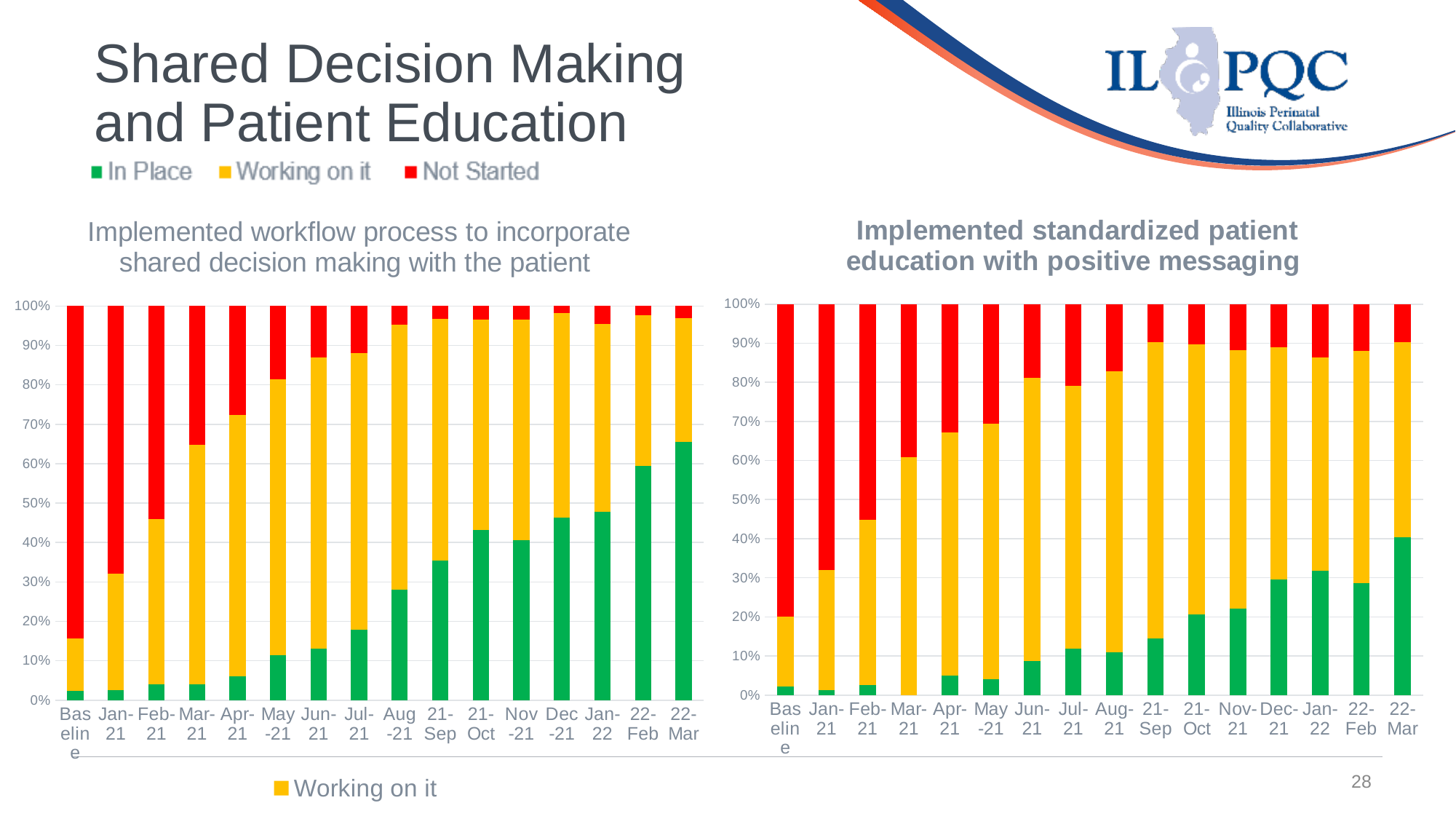
In the right chart, is the 'In Place' value for 22-Mar greater or less than 30%? greater In the right chart, does the 'In Place' share generally rise or fall from Baseline to 22-Mar? Rise Which chart shows the larger 'In Place' share for 22-Mar, the left chart or the right chart? The left chart In the right chart, which period has the largest 'Not Started' share? Baseline In the left chart, which period has the largest 'In Place' share? 22-Mar Which colour represents the 'Not Started' series in the legend? Red In the left chart, is the 'In Place' value for Aug-21 greater or less than 30%? less What kind of chart is the left chart, 'Implemented workflow process to incorporate shared decision making with the patient'? Stacked bar chart In the left chart, is the 'In Place' value for 22-Mar greater or less than 60%? greater How many series does the legend at the top of the slide list? 3 How many time-period categories are shown on the x axis of the right chart, 'Implemented standardized patient education with positive messaging'? 16